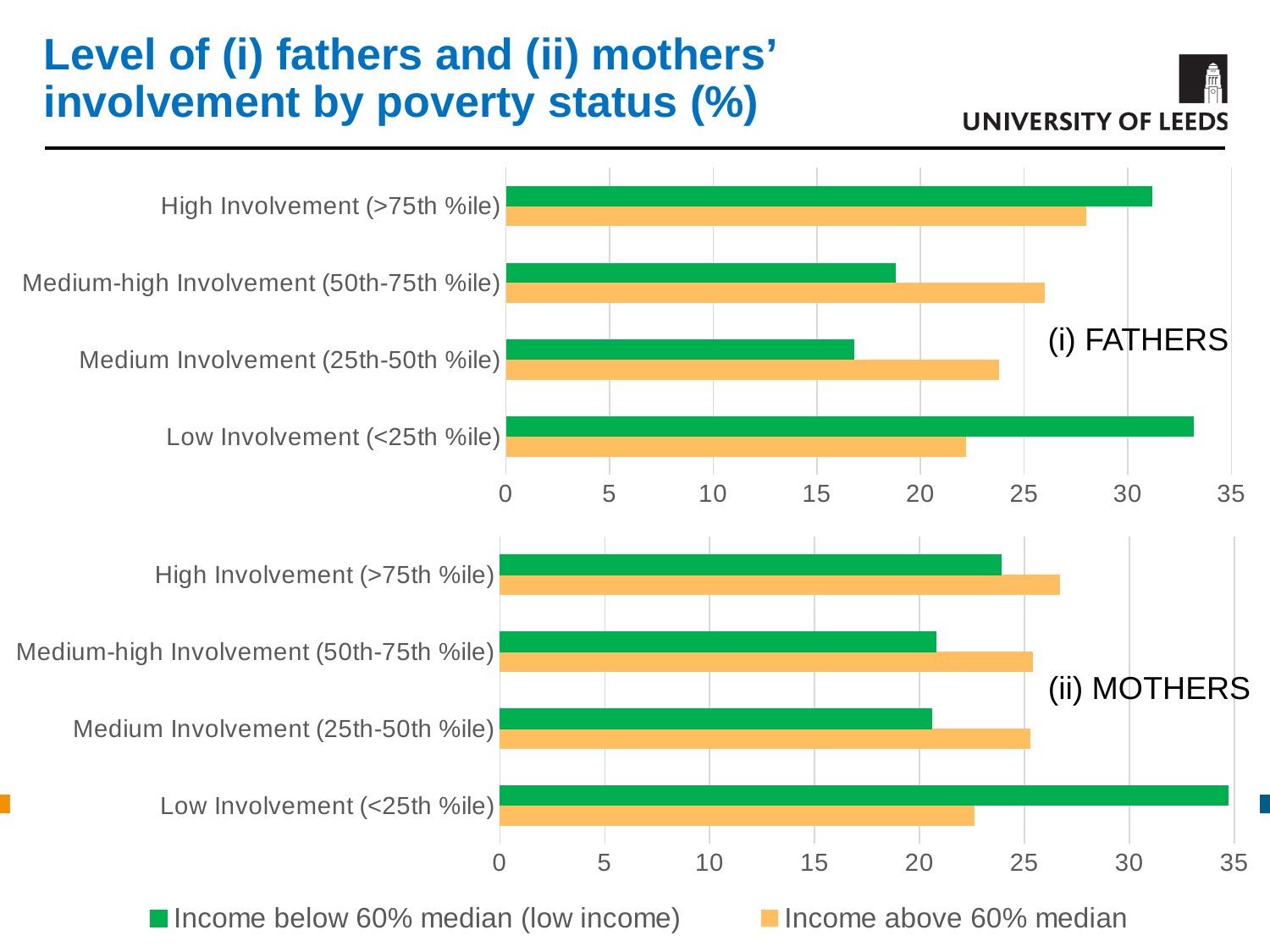
In the (i) FATHERS chart, is the value for Medium Involvement (25th-50th %ile) for Income below 60% median (low income) greater or less than 20? less What kind of chart is the (i) FATHERS chart? bar chart In the (ii) MOTHERS chart, for Low Involvement (<25th %ile), which series has the larger value: Income below 60% median (low income) or Income above 60% median? Income below 60% median (low income) In the (i) FATHERS chart, is the value for Low Involvement (<25th %ile) for Income below 60% median (low income) greater or less than 30? greater In the (ii) MOTHERS chart, is the value for Low Involvement (<25th %ile) for Income below 60% median (low income) greater or less than 30? greater In the (i) FATHERS chart, for Medium-high Involvement (50th-75th %ile), which series has the larger value: Income below 60% median (low income) or Income above 60% median? Income above 60% median In the (ii) MOTHERS chart, which involvement category has the highest value for Income below 60% median (low income)? Low Involvement (<25th %ile) Which colour represents Income above 60% median in the legend? orange How many involvement categories are shown in the (ii) MOTHERS chart? 4 How many series does the legend list for the charts? 2 In the (ii) MOTHERS chart, which involvement category has the lowest value for Income above 60% median? Low Involvement (<25th %ile)